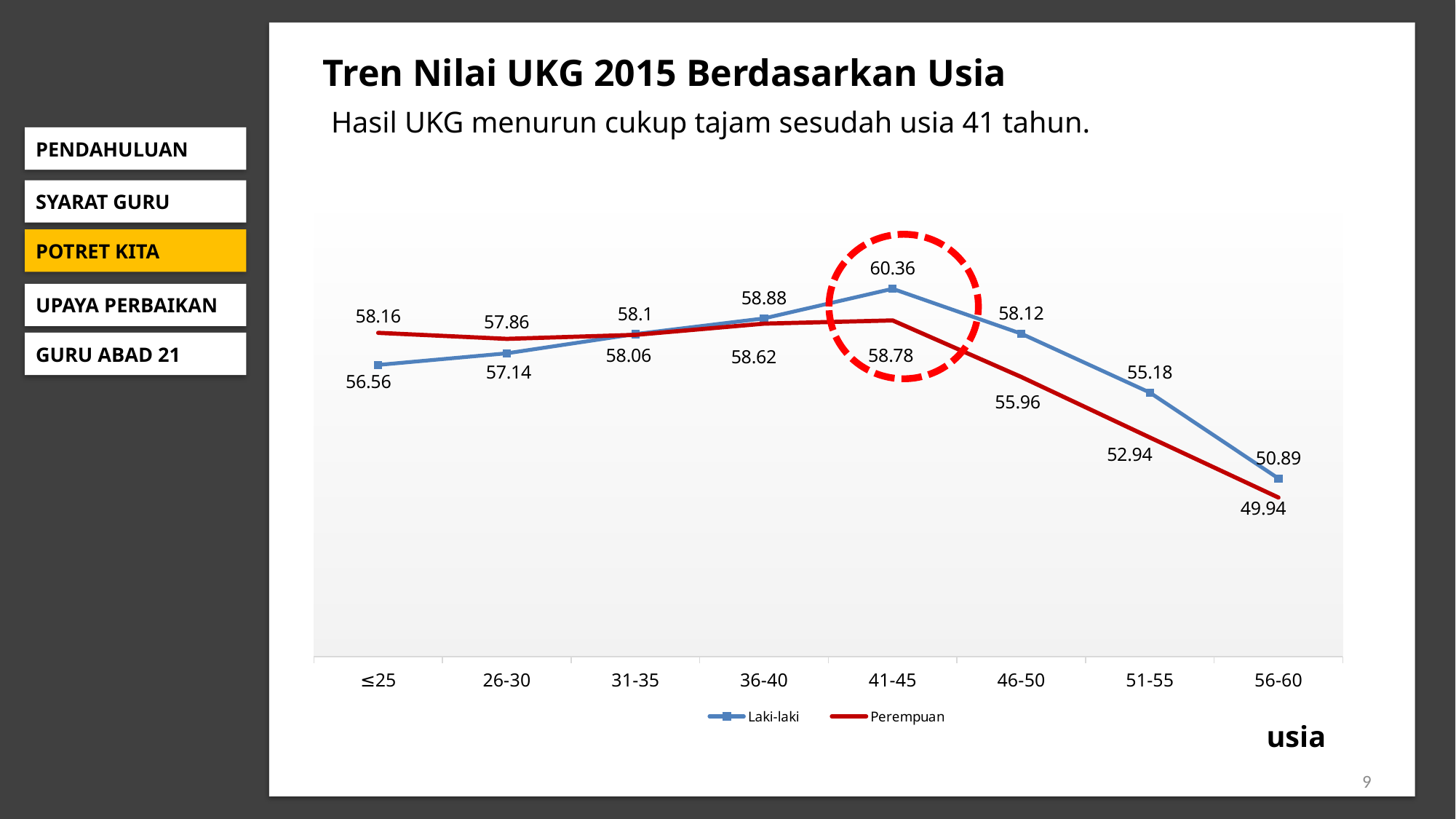
How many series does the legend list? 2 What is the Perempuan value for the ≤25 age group? 58.16 Which age group has the highest Laki-laki value? 41-45 What is the difference between the Laki-laki values for 41-45 and 56-60? 9.47 For the 46-50 age group, which series has the larger value, Laki-laki or Perempuan? Laki-laki What is the Perempuan value for the 56-60 age group? 49.94 What kind of chart is shown on the slide? line chart How many age categories are shown on the x axis? 8 What are the two series names listed in the legend? Laki-laki and Perempuan What is the Laki-laki value for the 41-45 age group? 60.36 Do the Laki-laki values rise or fall from the 41-45 age group to the 56-60 age group? fall Which age group has the lowest Perempuan value? 56-60